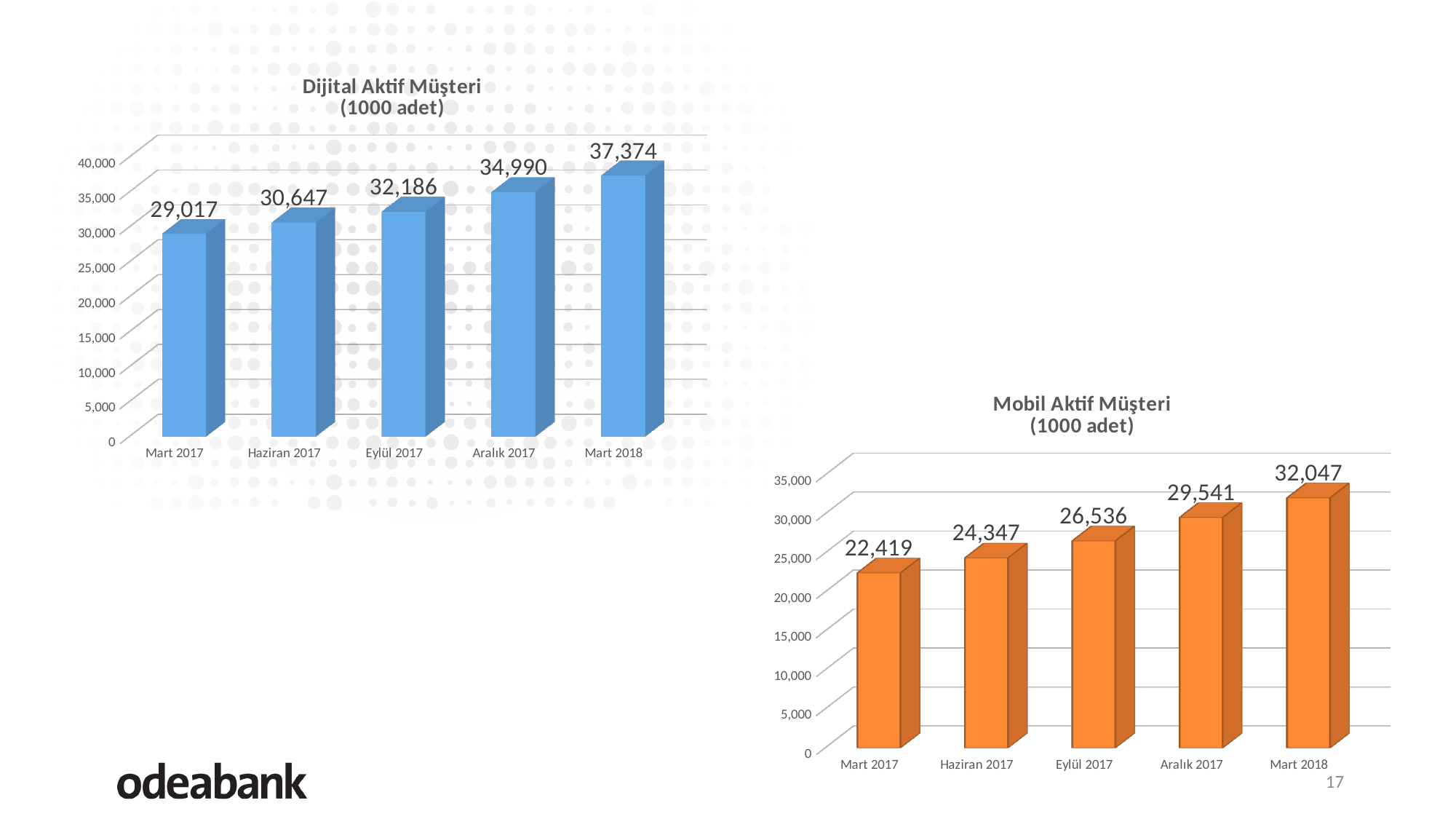
In the 'Mobil Aktif Müşteri (1000 adet)' chart, what is the value for Eylül 2017? 26,536 How many periods are shown in the 'Dijital Aktif Müşteri (1000 adet)' chart? 5 Which is larger: the Eylül 2017 value in the 'Dijital Aktif Müşteri' chart or the Mart 2018 value in the 'Mobil Aktif Müşteri' chart? Eylül 2017 in the Dijital Aktif Müşteri chart In the 'Dijital Aktif Müşteri (1000 adet)' chart, which period has the lowest value? Mart 2017 In the 'Dijital Aktif Müşteri (1000 adet)' chart, what is the value for Mart 2018? 37,374 What kind of chart is the 'Mobil Aktif Müşteri (1000 adet)' chart? Bar chart What colour are the bars in the 'Mobil Aktif Müşteri (1000 adet)' chart? Orange In the 'Dijital Aktif Müşteri (1000 adet)' chart, what is the difference between the Mart 2018 and Mart 2017 values? 8,357 In the 'Dijital Aktif Müşteri (1000 adet)' chart, do the values rise or fall from Mart 2017 to Mart 2018? Rise In the 'Mobil Aktif Müşteri (1000 adet)' chart, what is the difference between the Aralık 2017 and Haziran 2017 values? 5,194 In the 'Mobil Aktif Müşteri (1000 adet)' chart, is the value for Mart 2017 greater or less than 25,000? less In the 'Mobil Aktif Müşteri (1000 adet)' chart, which period has the highest value? Mart 2018